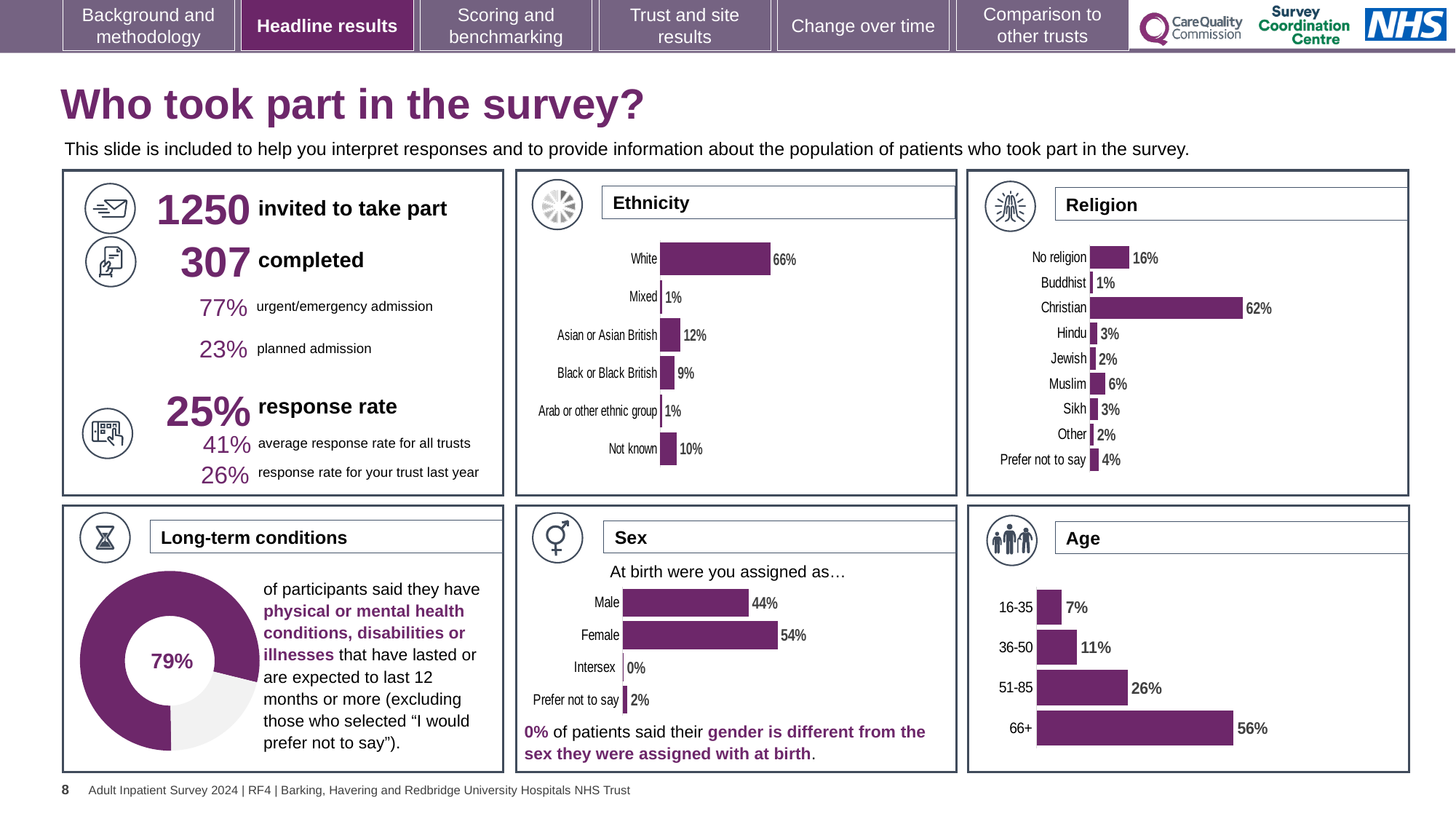
In the Sex chart, which is larger, Male or Female? Female In the Age chart, do the values rise or fall as the age groups increase from 16-35 to 66+? rise In the Age chart, which age group has the lowest value? 16-35 In the Ethnicity chart, which category has the highest value? White In the Sex chart, what is the difference between Female and Male? 10% In the Religion chart, what percentage of respondents were Christian? 62% In the Age chart, what percentage of respondents were aged 66+? 56% In the Religion chart, how many categories are shown? 9 In the Ethnicity chart, what percentage of respondents were White? 66% In the Ethnicity chart, how many categories are shown? 6 What kind of chart is used in the Long-term conditions panel? doughnut chart In the Religion chart, what is the difference between No religion and Muslim? 10%